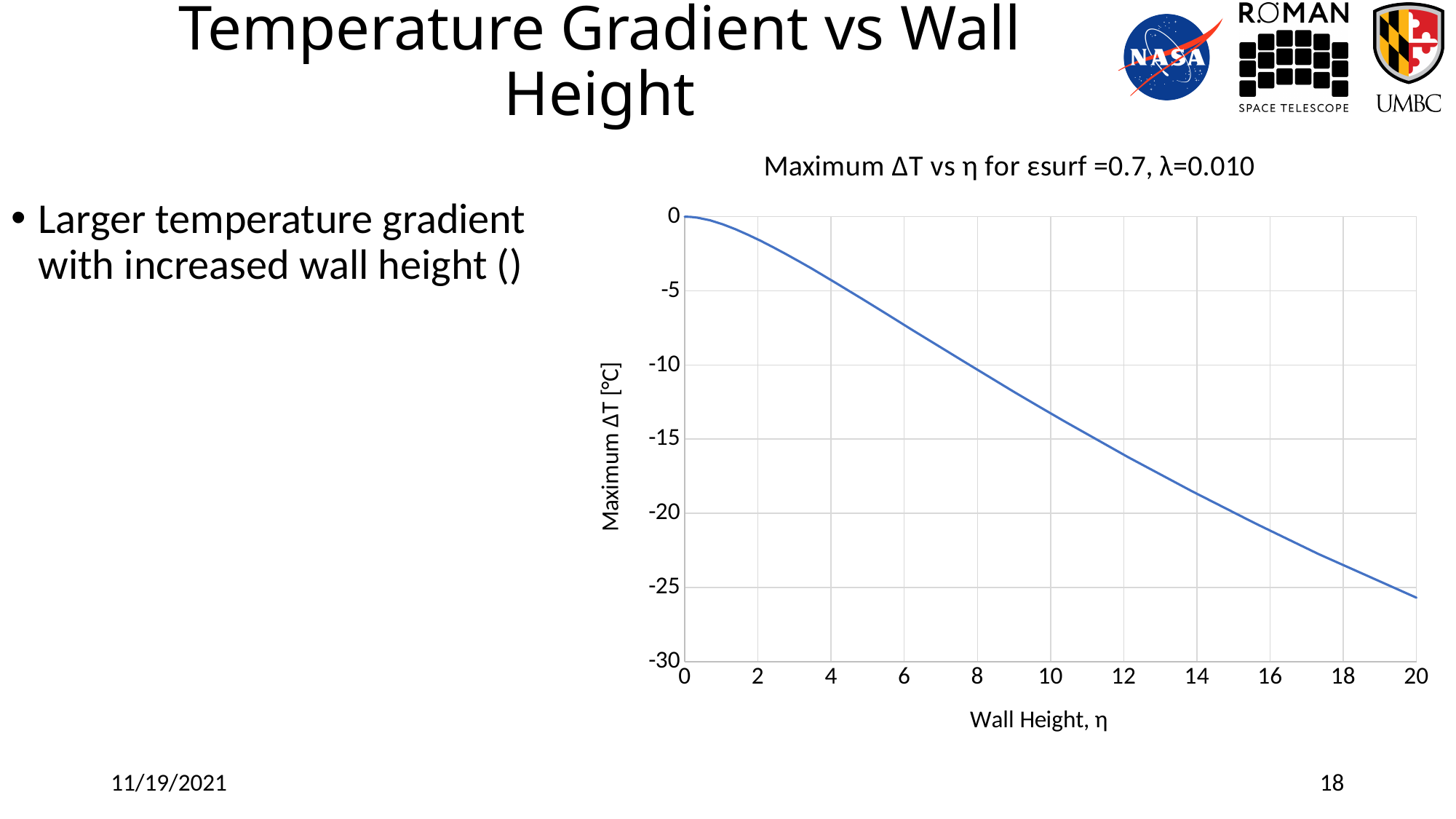
Is the Maximum ΔT at Wall Height η = 10 greater or less than -10? less Which Wall Height has the larger Maximum ΔT, η = 4 or η = 18? η = 4 Is the Maximum ΔT at Wall Height η = 2 greater or less than -5? greater What is the Maximum ΔT at Wall Height η = 0? 0 Is the Maximum ΔT at Wall Height η = 14 greater or less than -20? greater Does the Maximum ΔT rise or fall as Wall Height η increases from 0 to 20? fall What kind of chart is shown on the slide? line chart What is the title of the chart? Maximum ΔT vs η for εsurf =0.7, λ=0.010 What is the label of the x axis of the chart? Wall Height, η